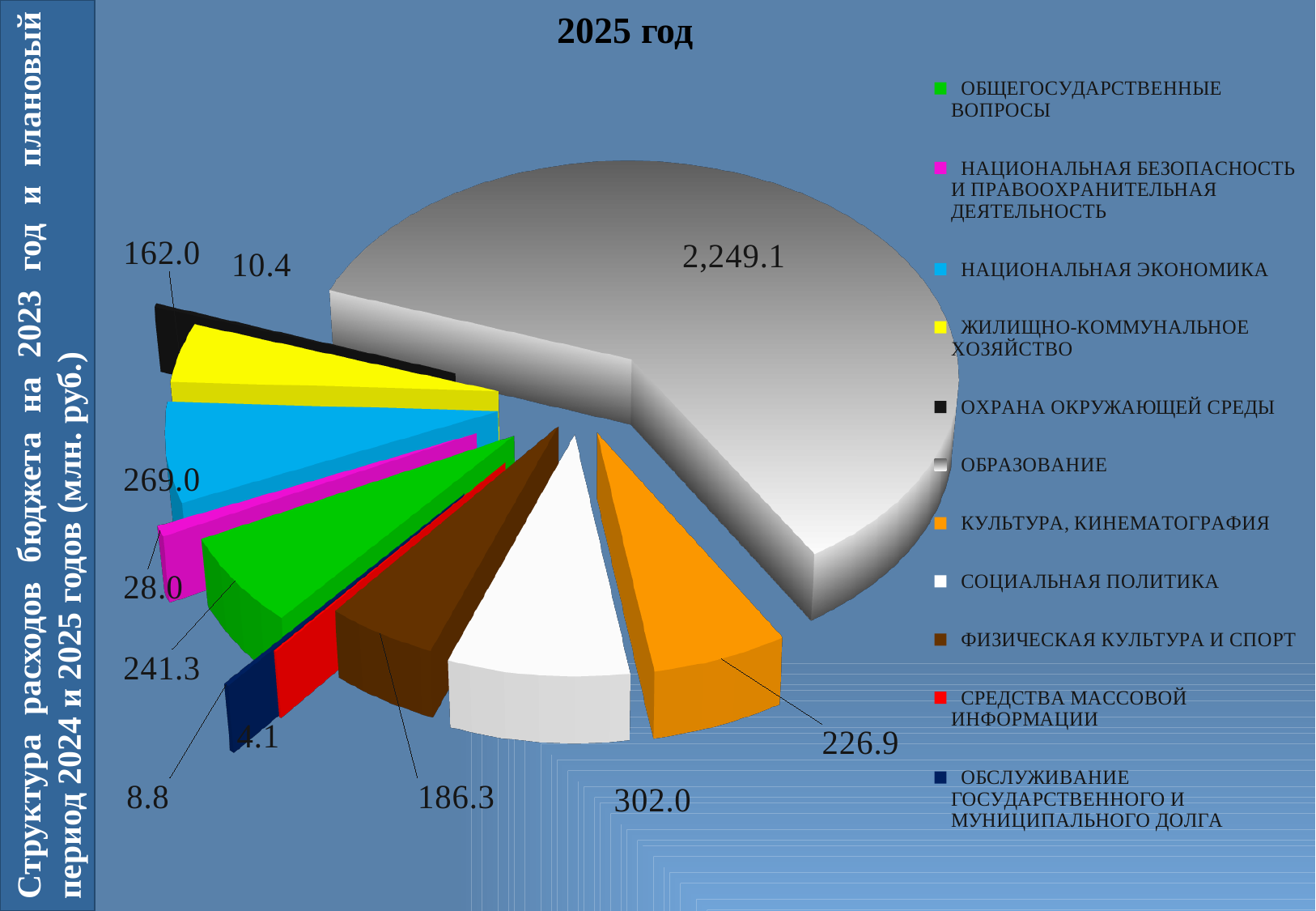
What is the value for ОБРАЗОВАНИЕ on the chart? 2,249.1 Which is larger, the value for НАЦИОНАЛЬНАЯ ЭКОНОМИКА or the value for ОБЩЕГОСУДАРСТВЕННЫЕ ВОПРОСЫ? НАЦИОНАЛЬНАЯ ЭКОНОМИКА How many categories does the legend of the chart list? 11 What is the difference between the values for СОЦИАЛЬНАЯ ПОЛИТИКА and КУЛЬТУРА, КИНЕМАТОГРАФИЯ? 75.1 What is the smallest value labelled on the chart? 4.1 What is the value for ФИЗИЧЕСКАЯ КУЛЬТУРА И СПОРТ on the chart? 186.3 What is the value for НАЦИОНАЛЬНАЯ БЕЗОПАСНОСТЬ И ПРАВООХРАНИТЕЛЬНАЯ ДЕЯТЕЛЬНОСТЬ on the chart? 28.0 What is the title of the chart? 2025 год What kind of chart is shown on the slide? pie chart What is the value for СОЦИАЛЬНАЯ ПОЛИТИКА on the chart? 302.0 What is the value for КУЛЬТУРА, КИНЕМАТОГРАФИЯ on the chart? 226.9 Which category has the largest slice of the pie? ОБРАЗОВАНИЕ